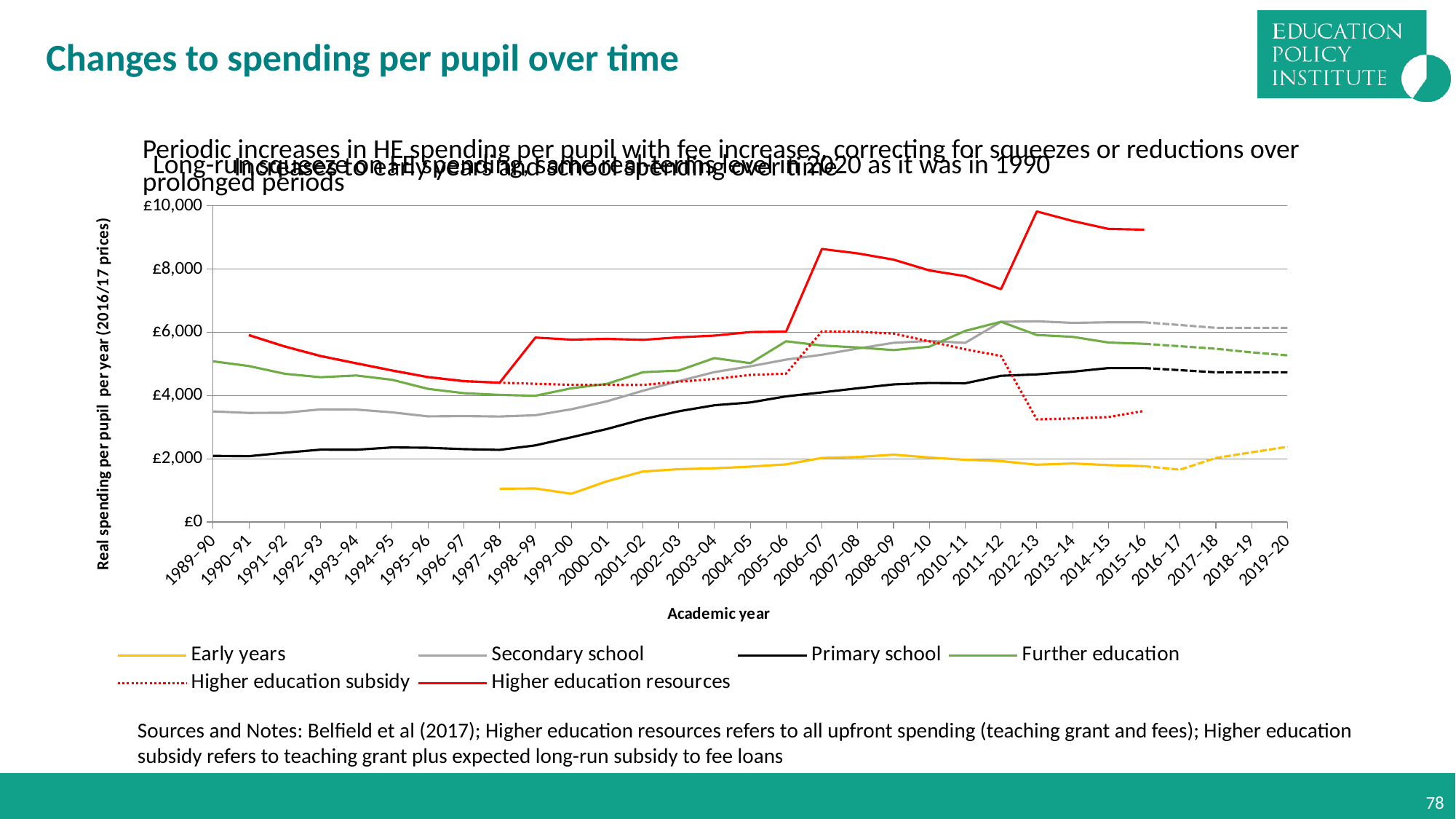
How many academic years are shown along the x axis of the chart? 31 Is the value for Primary school in 1989–90 greater or less than £4,000? less Which series has the highest value in 2019–20? Secondary school Is the value for Early years in 1999–00 greater or less than £2,000? less Is the value for Higher education resources in 2012–13 greater or less than £8,000? greater In 1989–90, which is larger: Further education or Secondary school? Further education How many series does the chart's legend list? 6 Does Primary school spending per pupil rise or fall between 1989–90 and 2015–16? Rise What kind of chart is shown on the slide? Line chart Which series has the lowest values across the whole chart? Early years What is the title of the chart's y axis? Real spending per pupil per year (2016/17 prices)